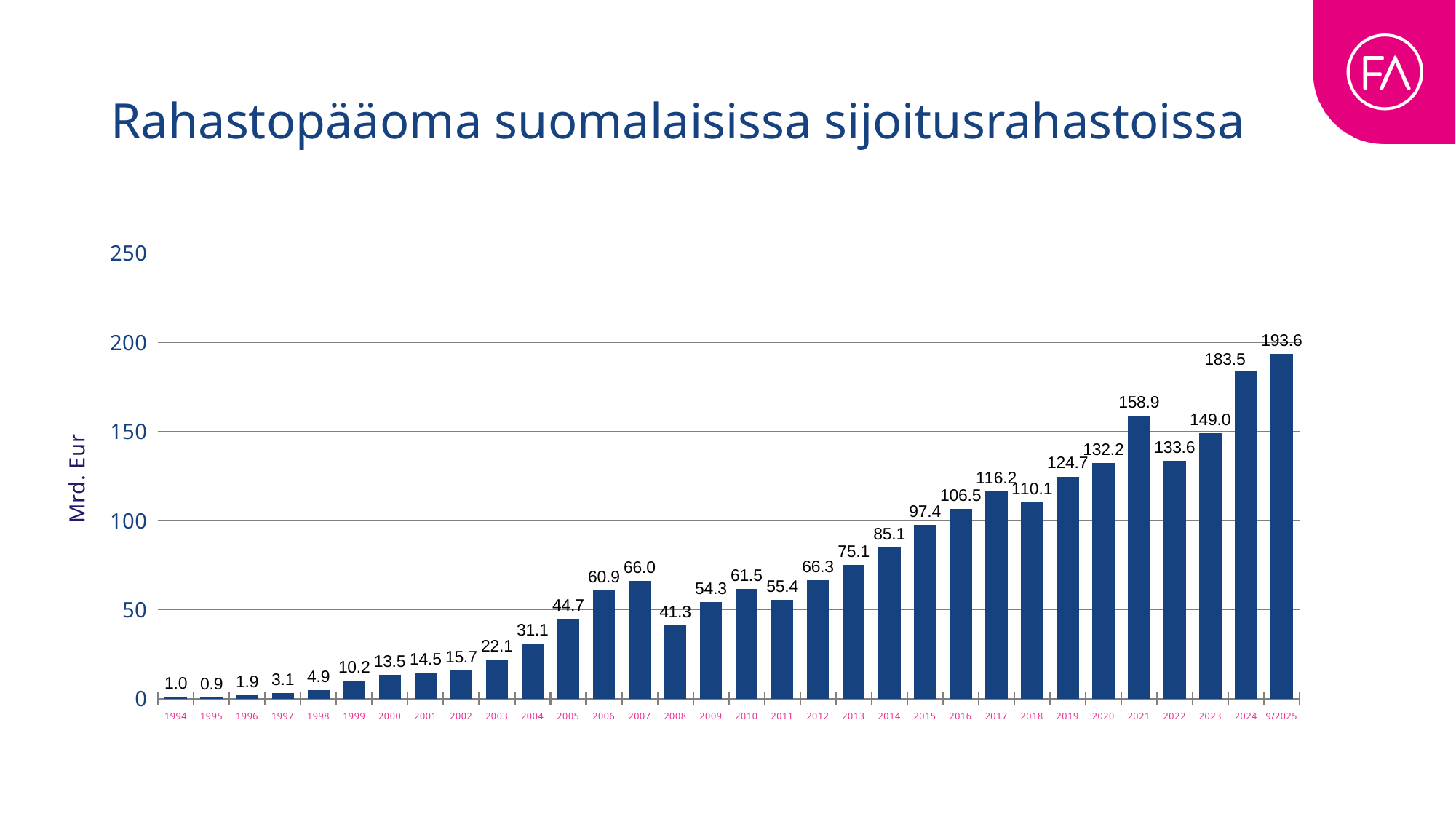
How many bars are shown in the chart? 32 Which year has the lowest value? 1995 Which year has the highest value? 9/2025 Which is larger, the value for 2021 or the value for 2022? 2021 What is the value for 2008? 41.3 What is the difference between the values for 2007 and 2008? 24.7 What is the value for 9/2025? 193.6 What is the value for 2015? 97.4 What is the label on the vertical axis? Mrd. Eur What kind of chart is shown on the slide? bar chart Is the value for 2019 greater or less than 100? greater What is the difference between the values for 2024 and 9/2025? 10.1